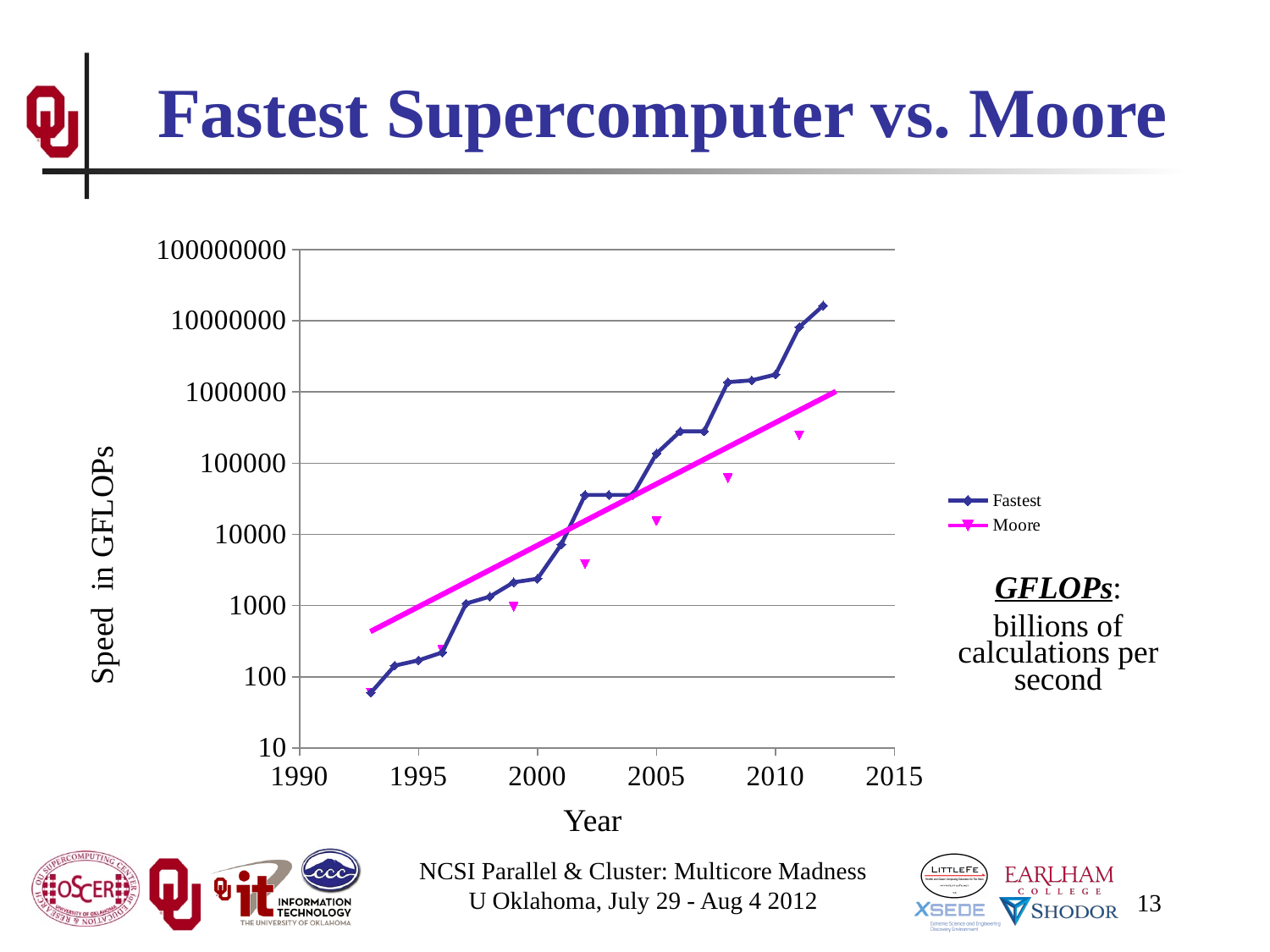
What kind of chart is shown on the slide? line chart Does the Fastest series rise or fall as the year increases? rise Is the Fastest value for 2000 greater or less than 1000? greater In 2008, which series has the higher value, Fastest or Moore? Fastest Is the Moore value for 2011 greater or less than 100000? greater Is the Fastest value for 2012 greater or less than 10000000? greater In which year does the Fastest series have its lowest value? 1993 What is the label of the y axis? Speed in GFLOPs What are the two series named in the legend? Fastest and Moore How many series does the legend list? 2 In which year does the Fastest series reach its highest value? 2012